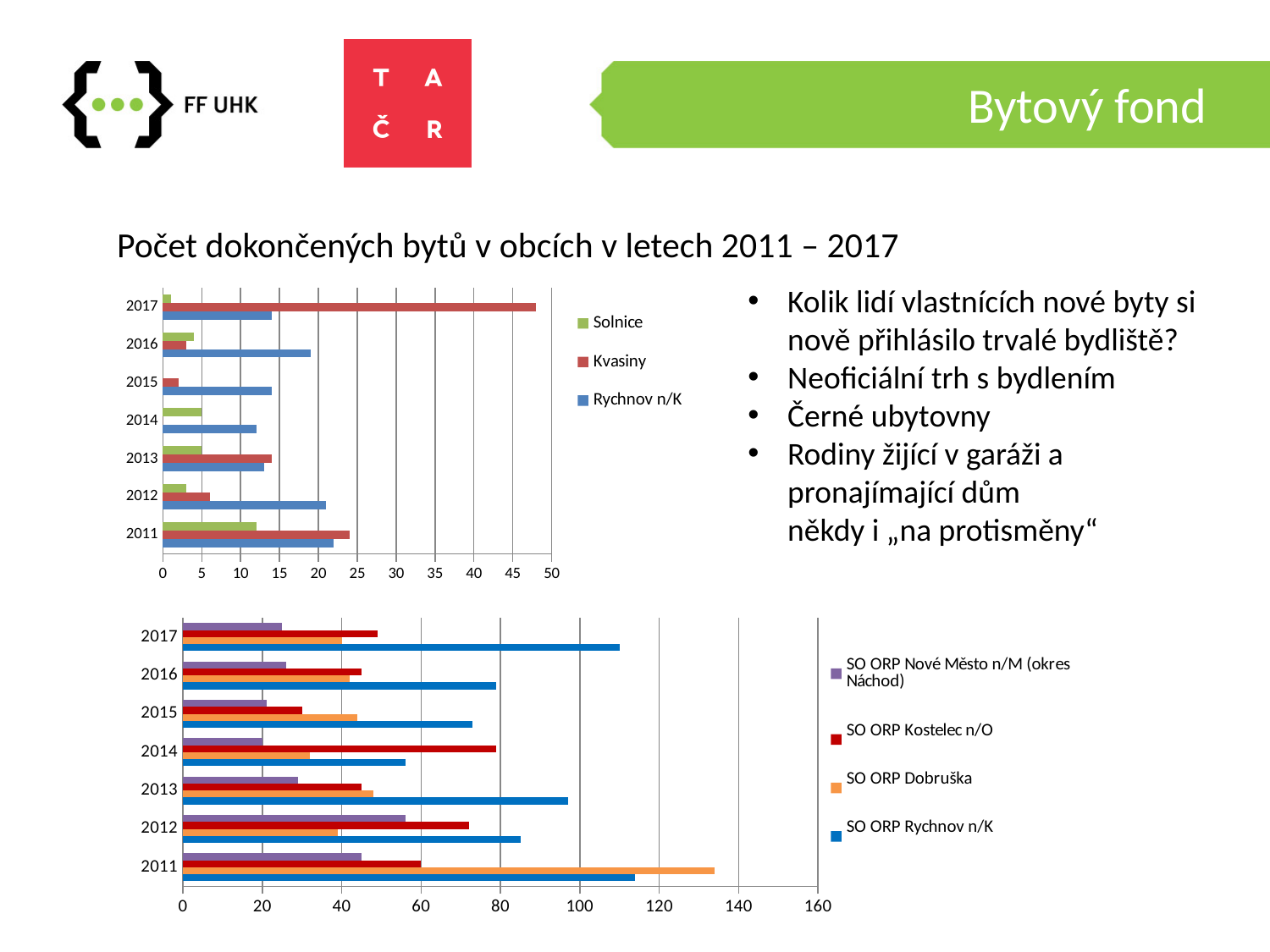
How many series does the legend of the bottom chart list? 4 In the bottom chart, is the value for SO ORP Rychnov n/K in 2017 greater or less than 100? greater In the bottom chart, which series has the highest value in 2011? SO ORP Dobruška How many years are shown on the top chart? 7 In the top chart, which series has the highest value in 2017? Kvasiny In the bottom chart, which series has the lowest value in 2013? SO ORP Nové Město n/M (okres Náchod) In the top chart, is the value for Kvasiny in 2017 greater or less than 40? greater What kind of chart is the top chart on the slide? bar chart In the top chart, is the value for Rychnov n/K in 2012 greater or less than 15? greater In the bottom chart, which is larger in 2014: SO ORP Kostelec n/O or SO ORP Rychnov n/K? SO ORP Kostelec n/O How many series does the legend of the top chart list? 3 In the top chart, which is larger in 2016: Kvasiny or Rychnov n/K? Rychnov n/K